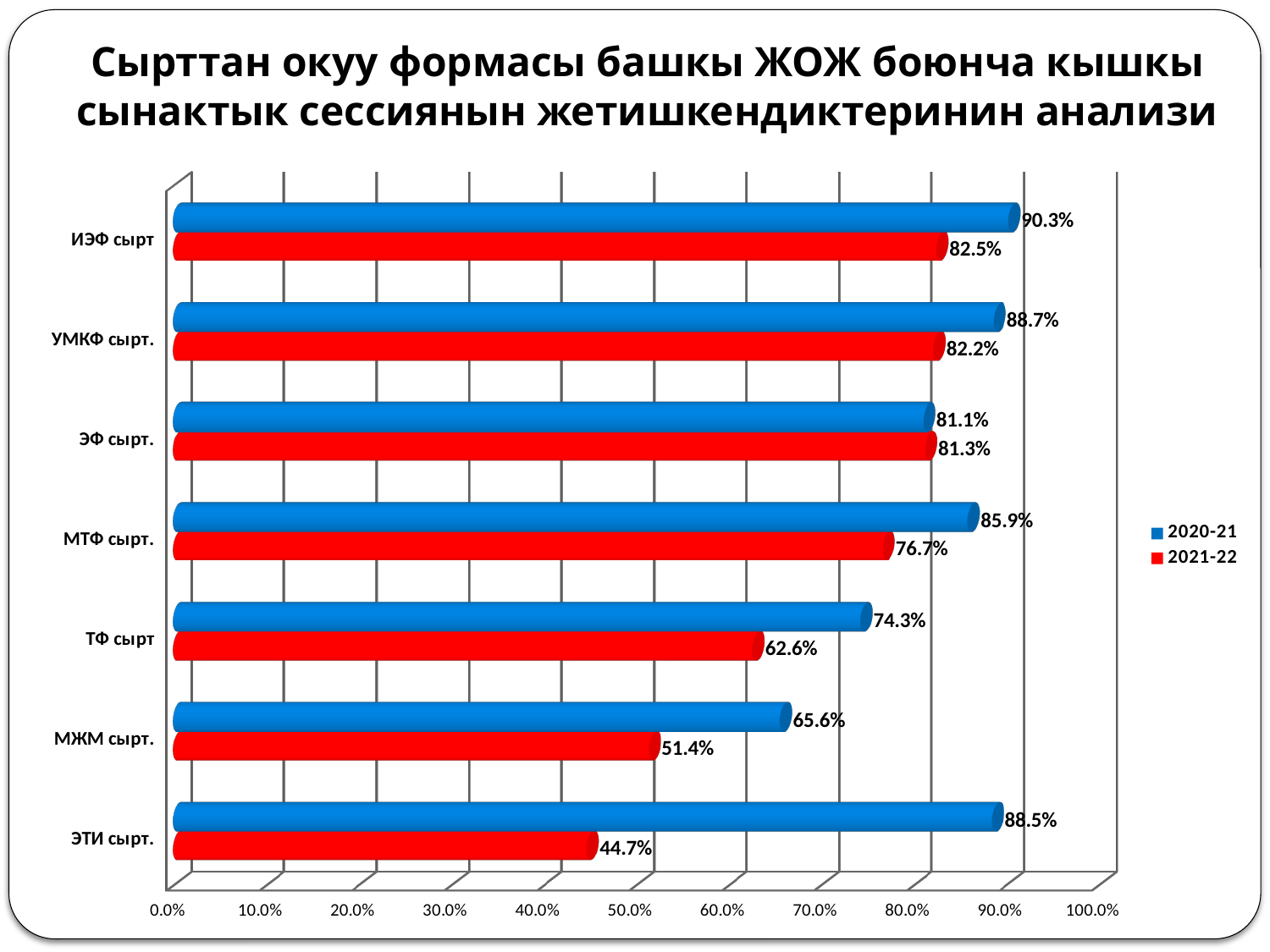
What is the difference between the 2020-21 and 2021-22 values for ЭТИ сырт.? 43.8% Which category has the highest 2020-21 value? ИЭФ сырт Which is larger for МЖМ сырт.: the 2020-21 value or the 2021-22 value? 2020-21 What is the difference between the 2020-21 and 2021-22 values for ТФ сырт? 11.7% How many categories are shown on the chart? 7 What is the 2020-21 value for ИЭФ сырт? 90.3% Which colour represents the 2021-22 series? Red How many series does the legend list? 2 Which category has the lowest 2021-22 value? ЭТИ сырт. What is the 2021-22 value for МТФ сырт.? 76.7% What kind of chart is shown on the slide? Bar chart What is the 2021-22 value for ЭТИ сырт.? 44.7%